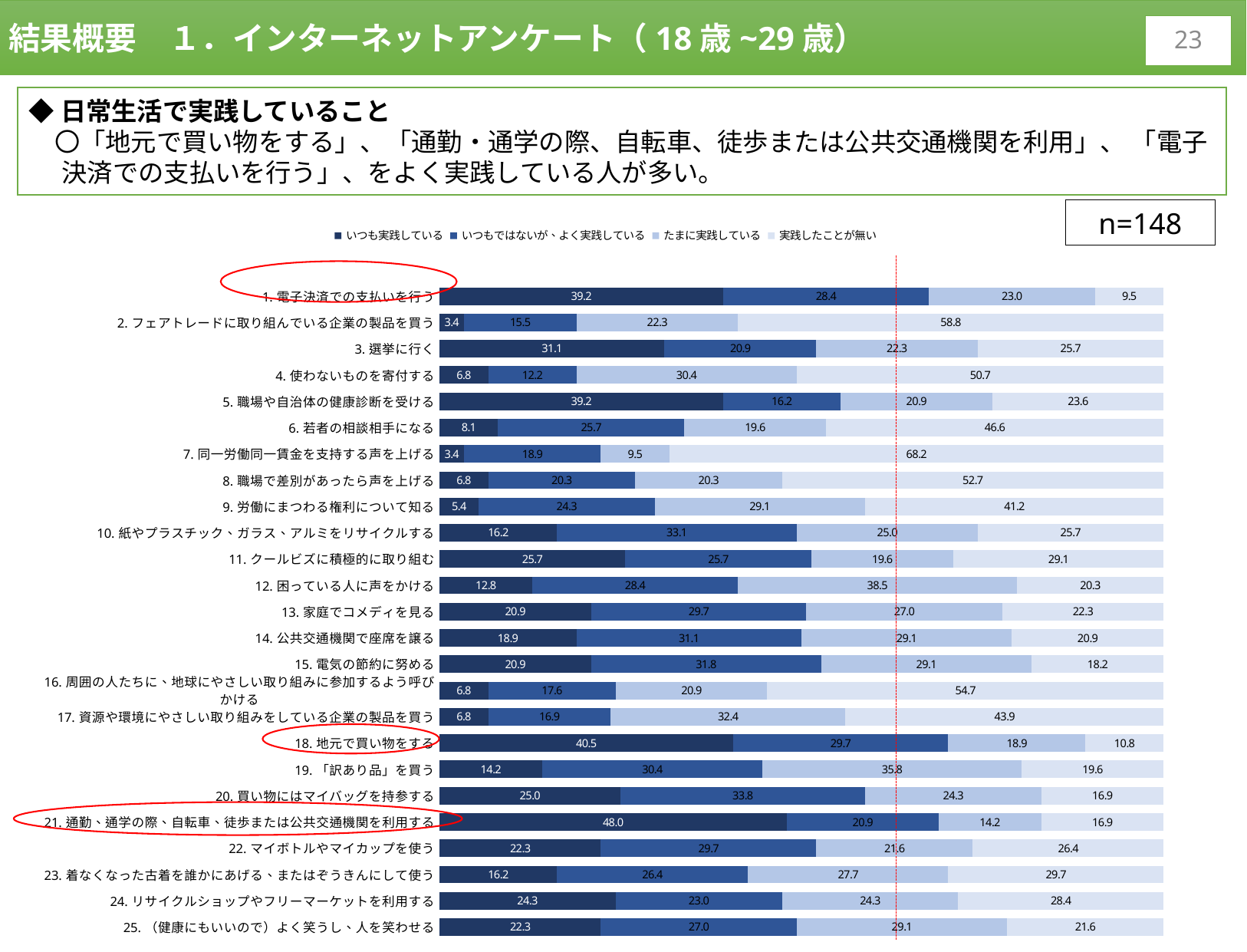
What is the difference between the いつも実践している values for 21. 通勤、通学の際、自転車、徒歩または公共交通機関を利用する and 18. 地元で買い物をする? 7.5 Which category has the lowest value for 実践したことが無い? 1. 電子決済での支払いを行う What is the value of いつも実践している for 21. 通勤、通学の際、自転車、徒歩または公共交通機関を利用する? 48.0 Which has the larger たまに実践している value: 12. 困っている人に声をかける or 19. 「訳あり品」を買う? 12. 困っている人に声をかける Which category has the highest value for 実践したことが無い? 7. 同一労働同一賃金を支持する声を上げる What kind of chart is shown on the slide? Stacked bar chart Which category has the highest value for いつも実践している? 21. 通勤、通学の際、自転車、徒歩または公共交通機関を利用する How many categories are plotted in the chart? 25 What is the value of いつも実践している for 18. 地元で買い物をする? 40.5 How many series does the legend list? 4 What is the value of たまに実践している for 12. 困っている人に声をかける? 38.5 What is the value of 実践したことが無い for 7. 同一労働同一賃金を支持する声を上げる? 68.2